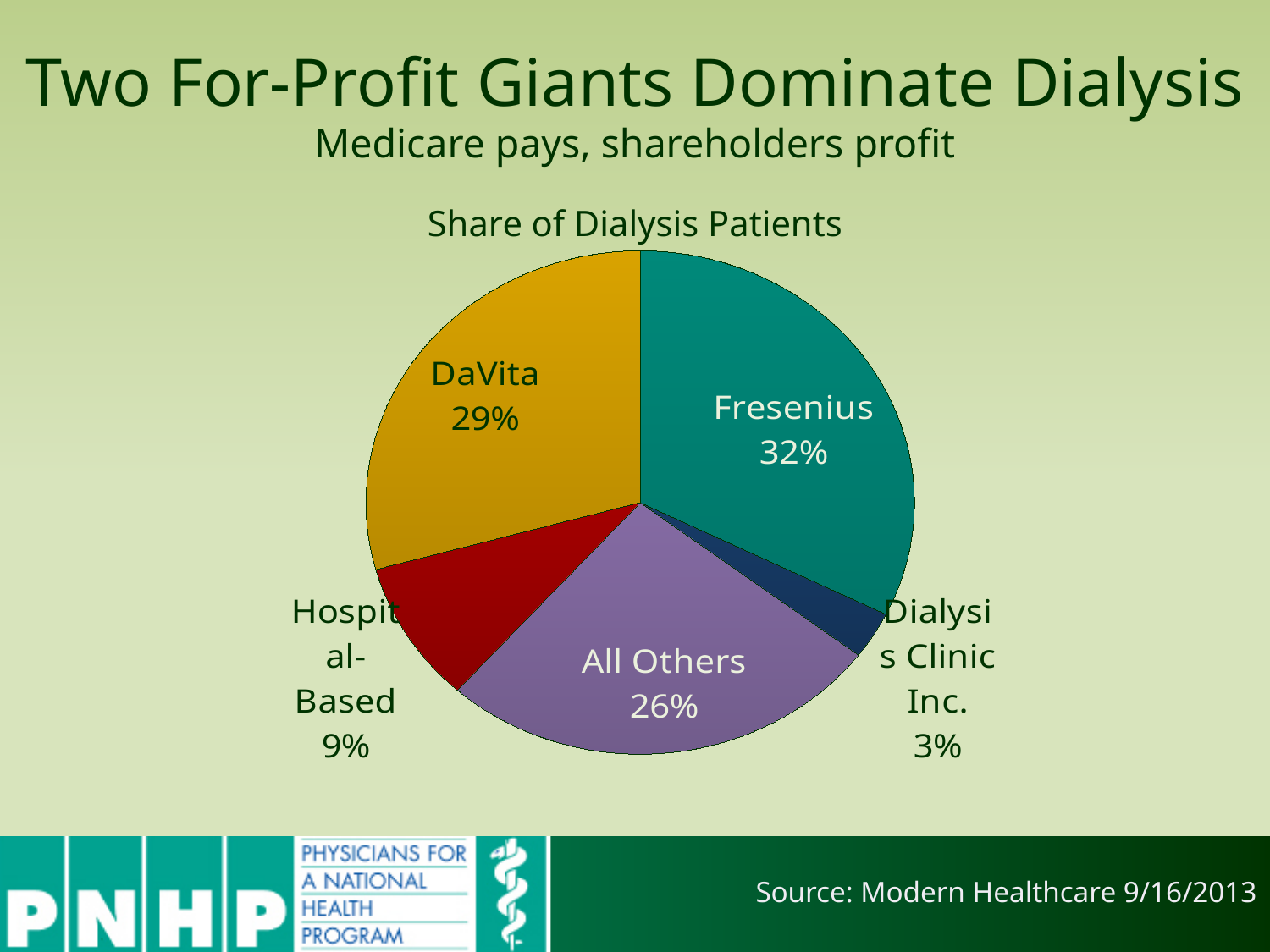
What share of dialysis patients does DaVita have? 29% How many slices does the pie chart have? 5 What is the chart's title? Share of Dialysis Patients What share of dialysis patients does Dialysis Clinic Inc. have? 3% Which is larger, the All Others share or the Hospital-Based share? All Others What share of dialysis patients does Fresenius have? 32% Which slice of the pie is the smallest? Dialysis Clinic Inc. What share of dialysis patients is Hospital-Based? 9% Which slice of the pie is the largest? Fresenius What is the combined share of Fresenius and DaVita? 61% What is the difference between the Fresenius share and the DaVita share? 3% What type of chart is shown on the slide? pie chart